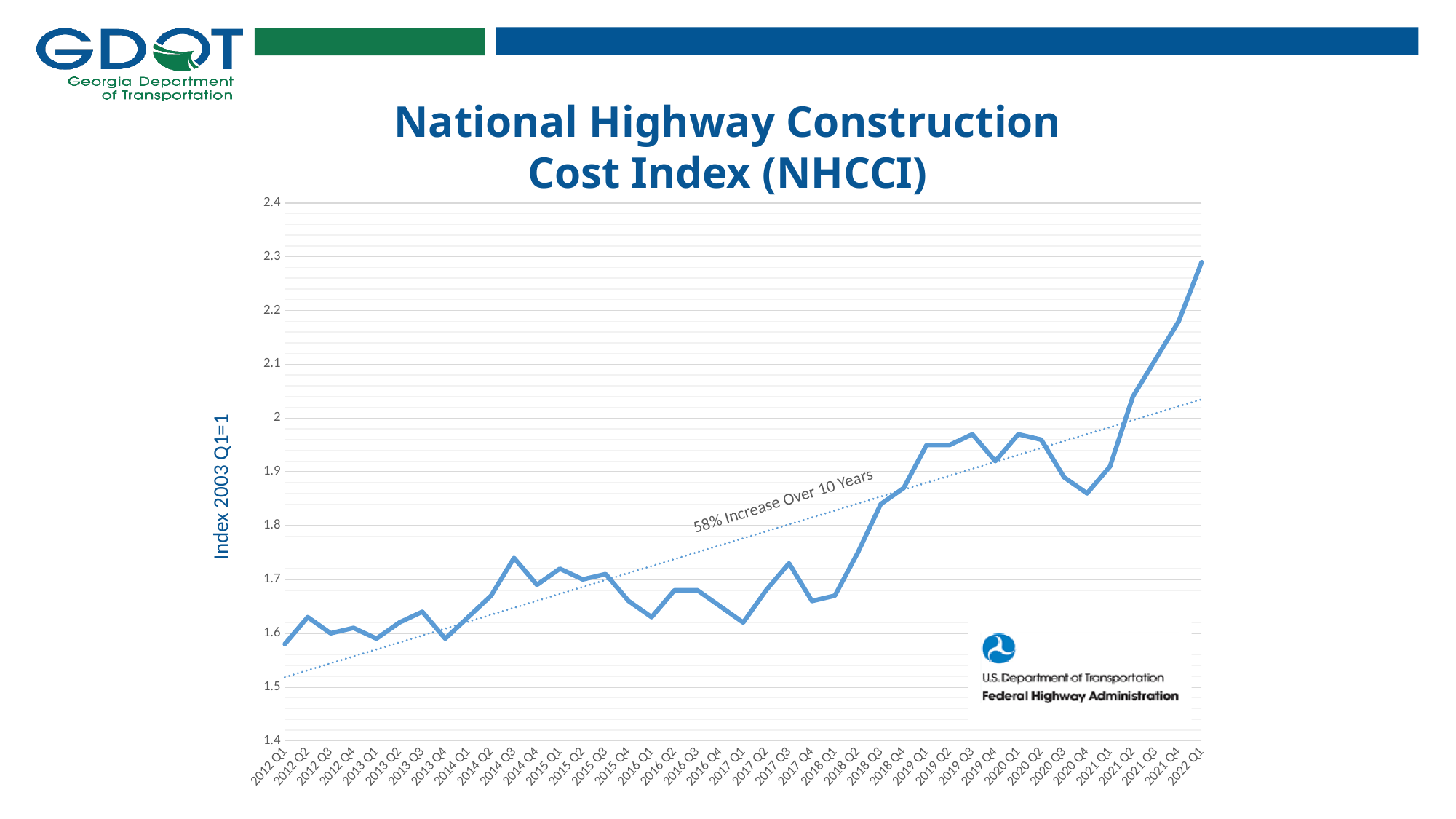
Is the value for 2017 Q1 greater or less than 1.7? less Overall, do the values rise or fall from 2012 Q1 to 2022 Q1? rise What is the label on the vertical axis of the chart? Index 2003 Q1=1 What is the title of the chart? National Highway Construction Cost Index (NHCCI) What kind of chart is shown on the slide? line chart Which is larger, the value for 2012 Q1 or the value for 2022 Q1? 2022 Q1 Is the value for 2022 Q1 greater or less than 2.2? greater Which is larger, the value for 2018 Q3 or the value for 2016 Q1? 2018 Q3 Is the value for 2014 Q3 greater or less than 1.7? greater Which quarter has the highest value on the chart? 2022 Q1 How many quarterly data points are plotted on the chart? 41